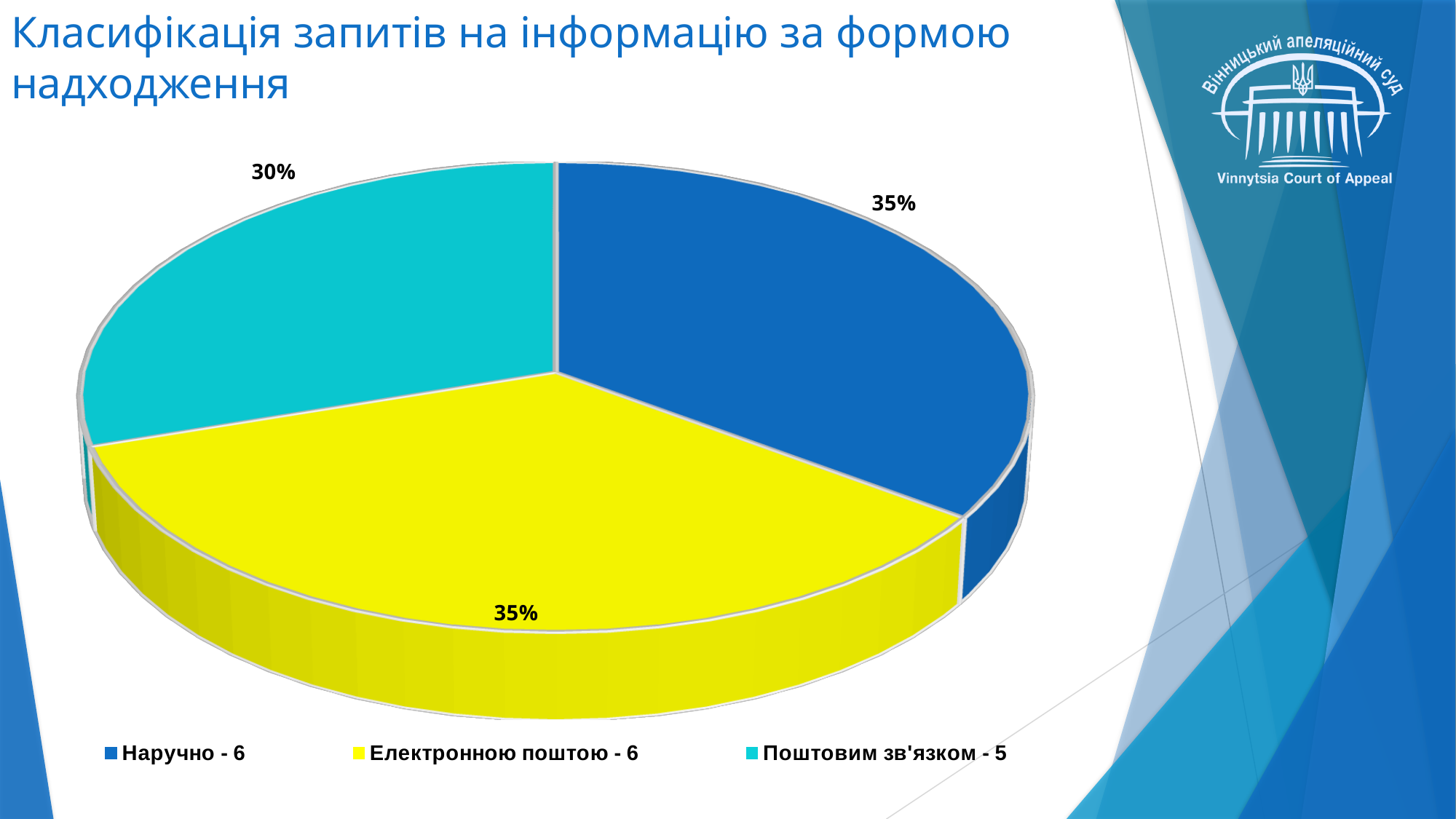
Which category has the smallest share of the pie? Поштовим зв'язком - 5 How many entries does the legend list? 3 What percentage share does the slice "Електронною поштою - 6" have? 35% What percentage share does the slice "Поштовим зв'язком - 5" have? 30% What is the title of the slide containing the chart? Класифікація запитів на інформацію за формою надходження How many slices does the pie chart have? 3 What is the difference in percentage points between the share for "Електронною поштою - 6" and the share for "Поштовим зв'язком - 5"? 5 What kind of chart is shown on the slide? Pie chart What percentage share does the slice "Наручно - 6" have? 35% What colour is the slice for "Електронною поштою - 6"? Yellow Which is larger: the share for "Наручно - 6" or the share for "Поштовим зв'язком - 5"? Наручно - 6